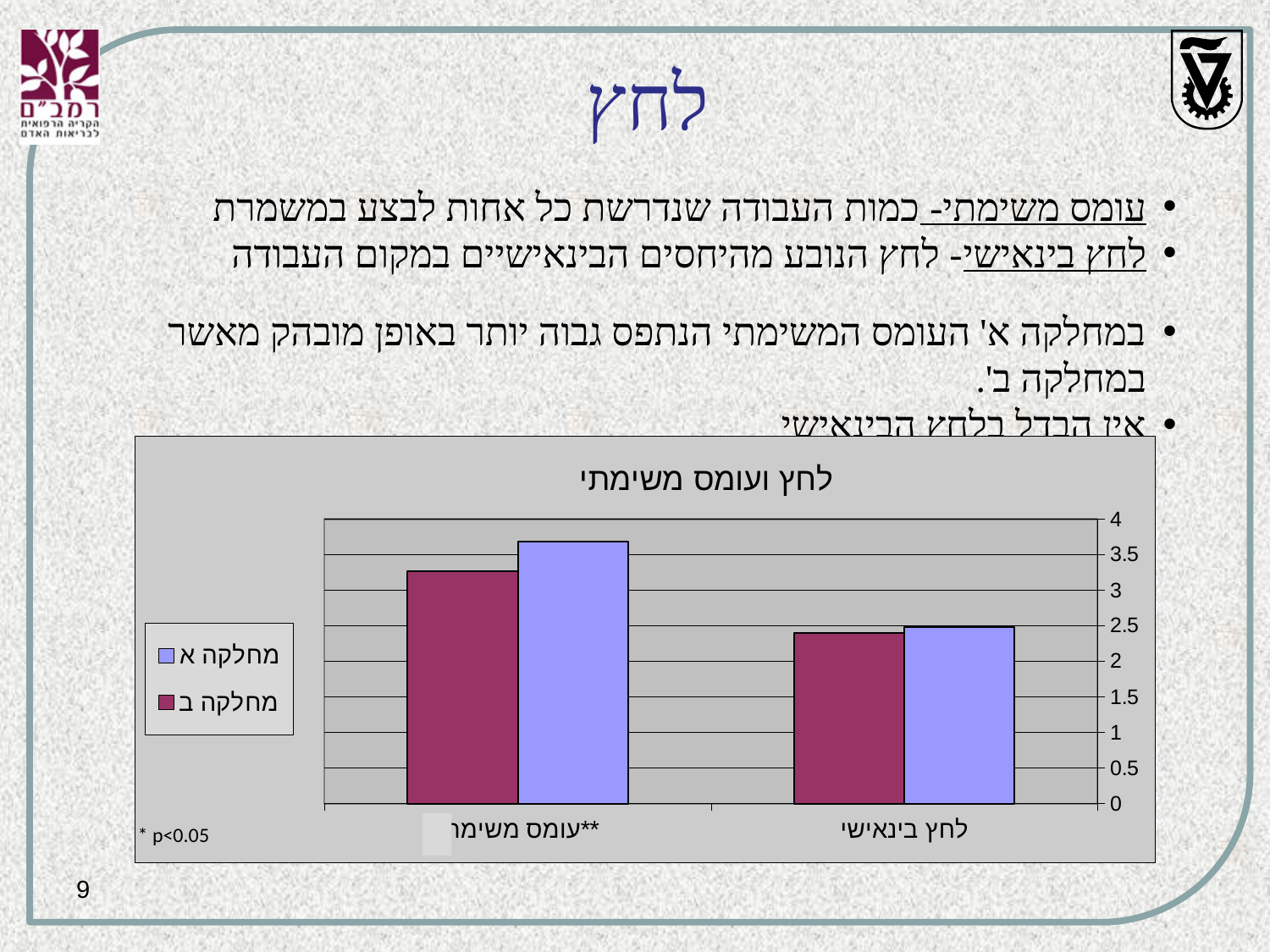
How many categories are shown on the x axis of the chart? 2 Is the value for מחלקה א in the category לחץ בינאישי greater or less than 3? less Is the value for מחלקה ב in the category לחץ בינאישי greater or less than 2? greater How many series does the chart legend list? 2 What type of chart is shown on the slide? bar chart Which category has the highest bar in the chart? עומס משימתי Which series is shown in light blue in the chart legend? מחלקה א Is the value for מחלקה ב in the category עומס משימתי greater or less than 3? greater For the category עומס משימתי, which series has the taller bar, מחלקה א or מחלקה ב? מחלקה א What is the title of the chart? לחץ ועומס משימתי